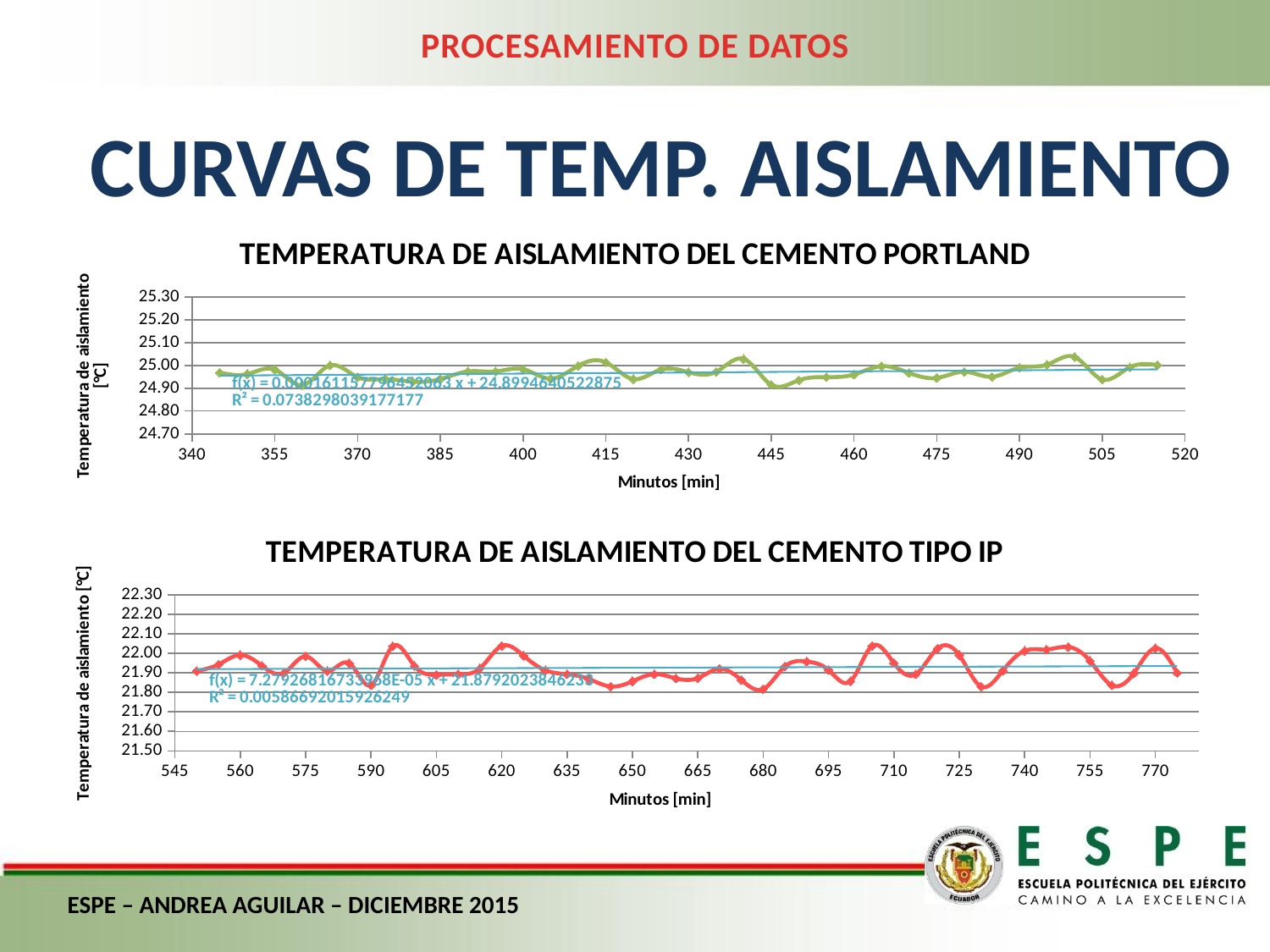
On the 'CEMENTO TIPO IP' chart, which is higher: the temperature at 620 minutes or at 680 minutes? 620 minutes On the 'CEMENTO TIPO IP' chart, is the temperature at 620 minutes greater or less than 21.90? greater On the 'CEMENTO TIPO IP' chart, is the temperature at 680 minutes greater or less than 21.90? less On the 'CEMENTO PORTLAND' chart, which is higher: the temperature at 440 minutes or at 445 minutes? 440 minutes What kind of chart is the 'TEMPERATURA DE AISLAMIENTO DEL CEMENTO TIPO IP' chart? line chart What is the x-axis label of the 'CEMENTO PORTLAND' chart? Minutos [min] On the 'CEMENTO PORTLAND' chart, is the temperature at 440 minutes greater or less than 24.90? greater What R² value is shown on the 'CEMENTO TIPO IP' chart? 0.00586692015926249 What kind of chart is the 'TEMPERATURA DE AISLAMIENTO DEL CEMENTO PORTLAND' chart? line chart